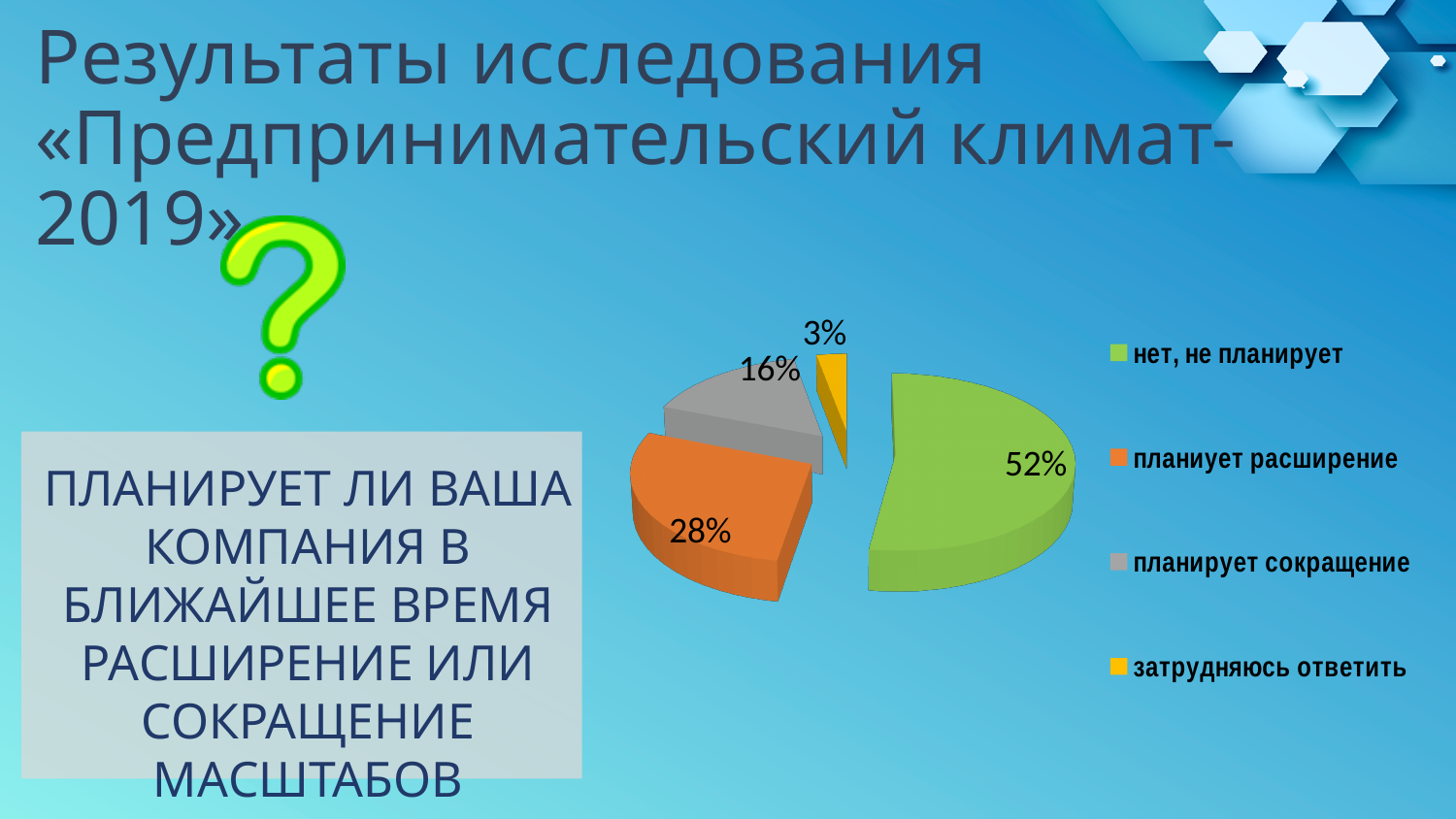
What share of the pie is labelled "нет, не планирует"? 52% What is the difference between the shares for "нет, не планирует" and "планиует расширение"? 24% What colour is the slice for "планиует расширение"? orange Which is larger: the share for "планирует сокращение" or the share for "затрудняюсь ответить"? планирует сокращение Which category has the largest slice of the pie? нет, не планирует What kind of chart is shown on the slide? pie chart How many entries does the legend list? 4 Which category has the smallest slice of the pie? затрудняюсь ответить What share of the pie is labelled "планиует расширение"? 28% How many slices does the pie chart have? 4 What share of the pie is labelled "затрудняюсь ответить"? 3% What share of the pie is labelled "планирует сокращение"? 16%